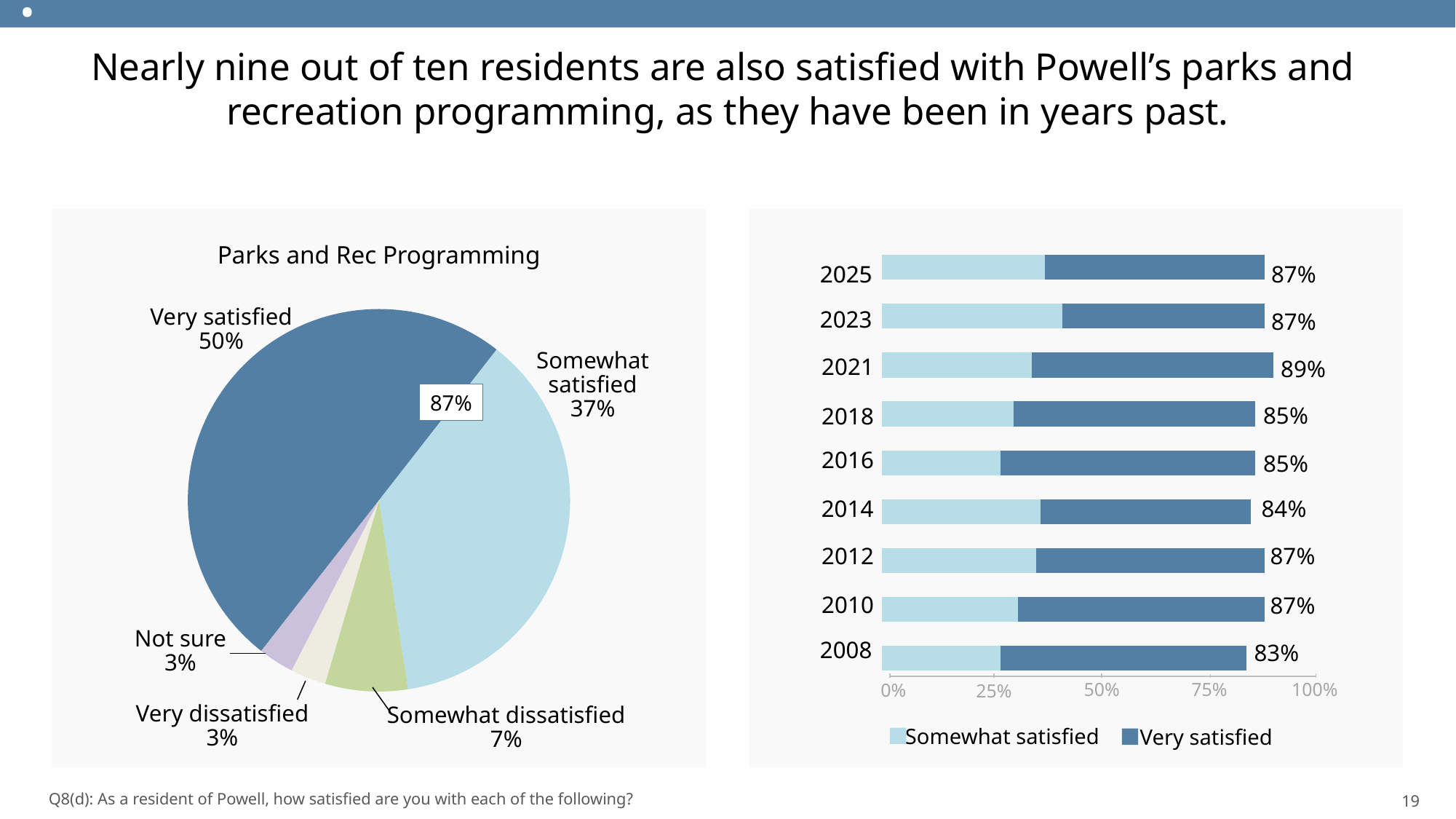
In the bar chart on the right, what is the difference between the total for 2021 and the total for 2008? 6 percentage points In the pie chart titled Parks and Rec Programming, how many slices are there? 5 What kind of chart is the chart on the left side of the slide? Pie chart In the bar chart on the right, which year has the highest total satisfied percentage? 2021 In the bar chart on the right, which year has the lowest total satisfied percentage? 2008 In the bar chart on the right, how many series does the legend list? 2 In the pie chart titled Parks and Rec Programming, which category has the largest slice? Very satisfied In the pie chart titled Parks and Rec Programming, what percentage of residents are Somewhat dissatisfied? 7% In the bar chart on the right, what is the total satisfied percentage for 2021? 89% In the pie chart titled Parks and Rec Programming, what percentage of residents are Very satisfied? 50% In the bar chart on the right, how many years are shown? 9 In the bar chart on the right, is the total for 2016 larger or smaller than the total for 2014? Larger